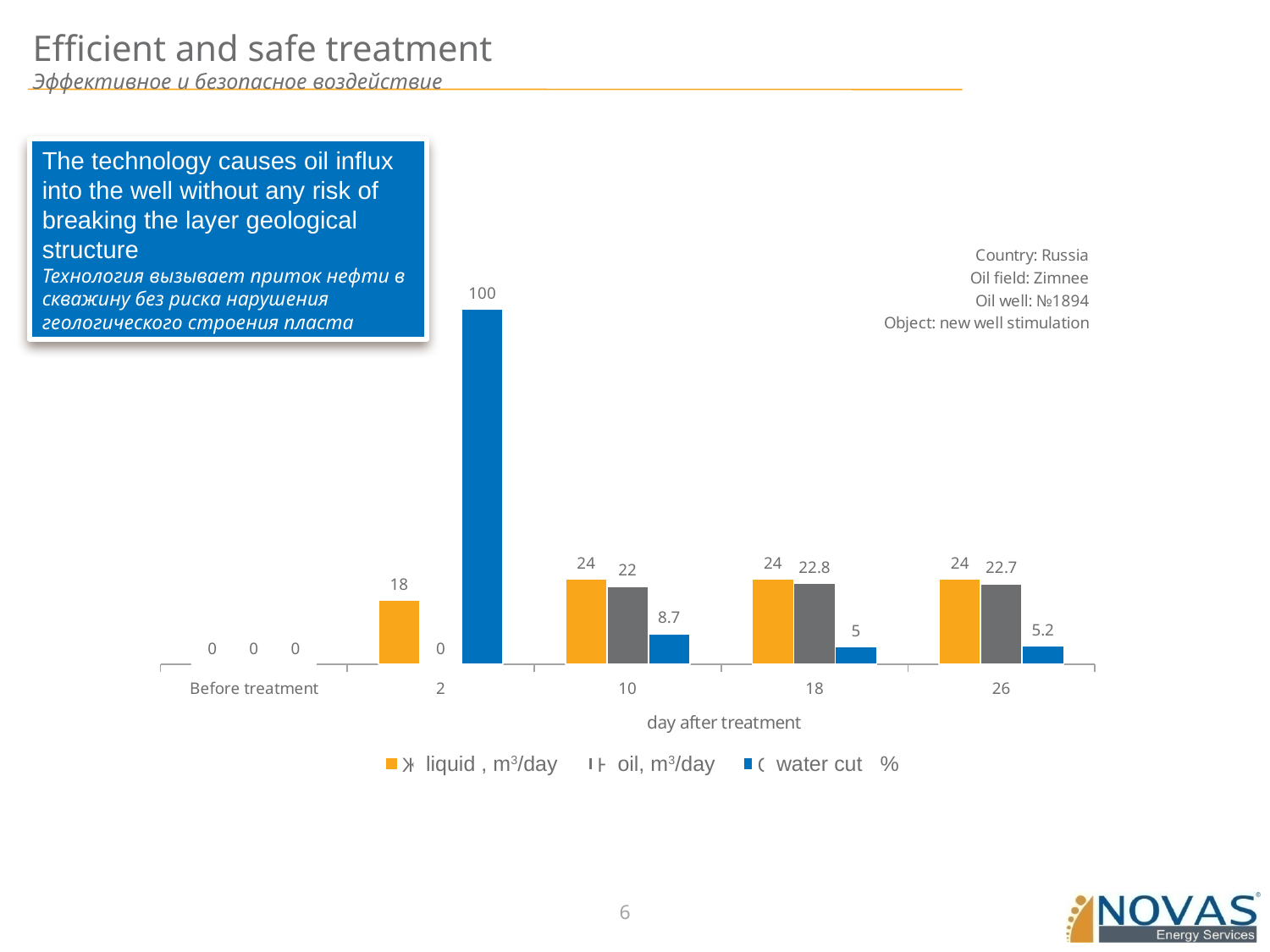
How many categories are shown on the x axis? 5 On which day after treatment is the water cut lowest (excluding Before treatment)? 18 What is the difference between the liquid and oil values on day 10 after treatment? 2 What is the water cut value on day 10 after treatment? 8.7 Which is larger: the water cut on day 18 or on day 26? day 26 What is the liquid value (m³/day) on day 26 after treatment? 24 On which day after treatment is the water cut highest? 2 How many series does the legend list? 3 What is the x-axis title of the chart? day after treatment What kind of chart is shown on the slide? bar chart What is the oil value (m³/day) on day 18 after treatment? 22.8 What is the water cut value on day 2 after treatment? 100